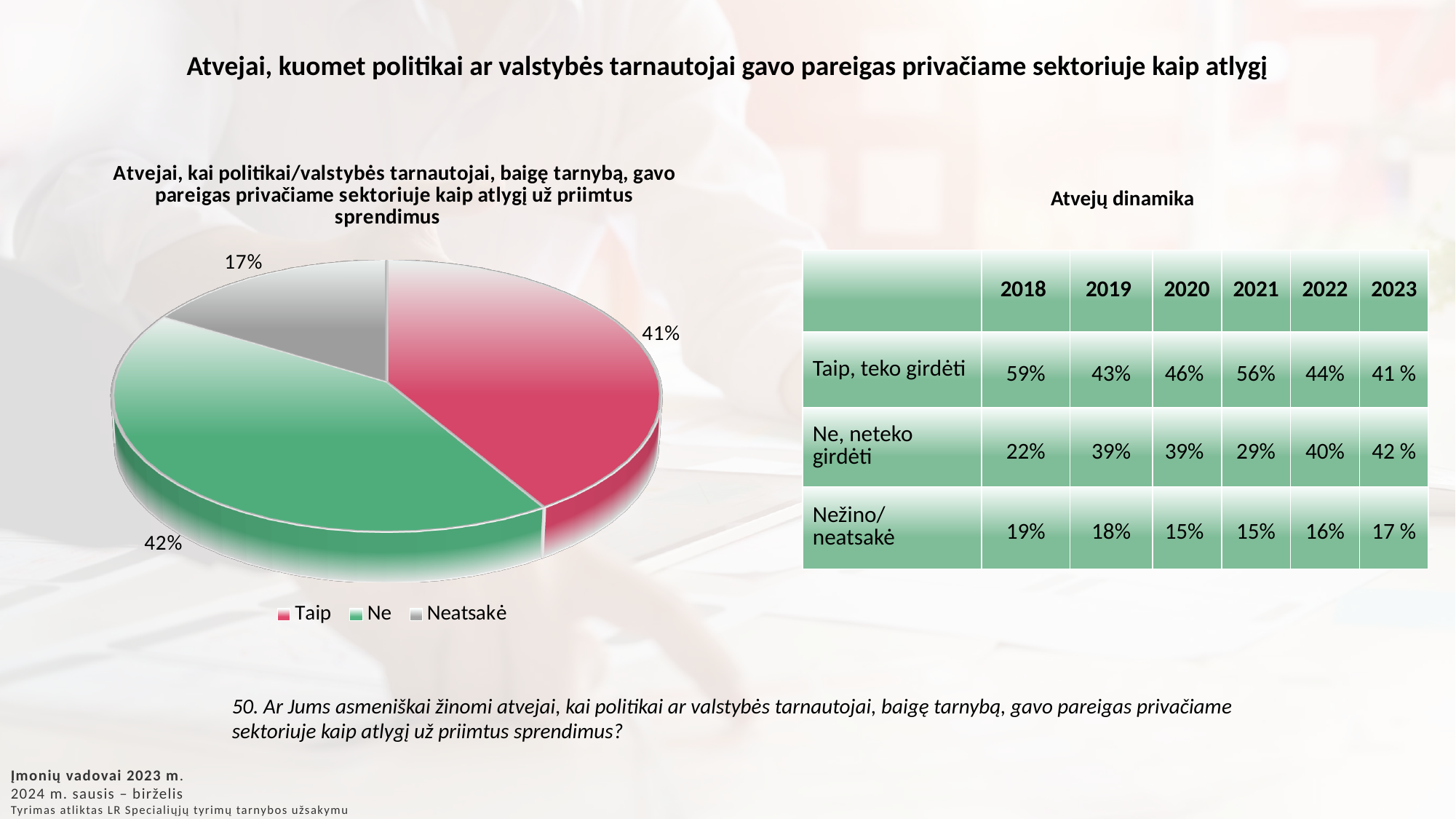
How many entries does the legend of the pie chart list? 3 According to the data labels, which is larger in the pie chart: "Taip" or "Ne"? Ne Which slice of the pie chart is the largest according to the data labels? Ne How many slices does the pie chart have? 3 What colour is the "Taip" slice in the pie chart? red What is the difference in percentage points between the "Taip" and "Neatsakė" slices of the pie chart? 24 In the pie chart, what share is labelled for "Ne"? 42% What kind of chart is shown on the left of the slide? pie chart In the pie chart, what share is labelled for "Taip"? 41% Which slice of the pie chart is the smallest? Neatsakė In the pie chart, what share is labelled for "Neatsakė"? 17% What is the difference in percentage points between the "Ne" and "Neatsakė" slices of the pie chart? 25